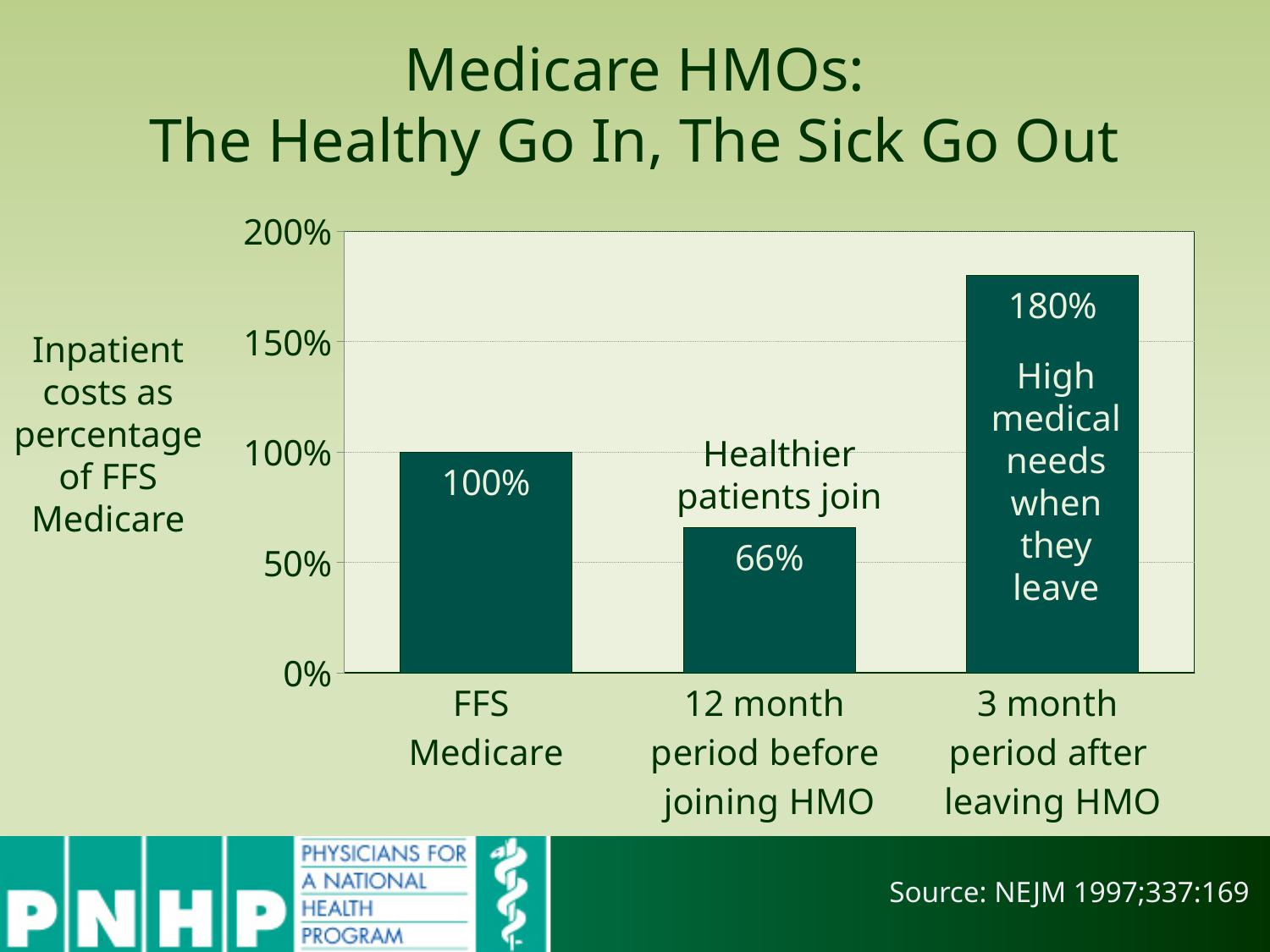
What is the value for the 3 month period after leaving HMO? 180% What kind of chart is shown on the slide? bar chart What does the y axis of the chart measure, according to the label on the left? Inpatient costs as percentage of FFS Medicare What is the value for FFS Medicare? 100% Is the value for the 3 month period after leaving HMO greater or less than 150%? greater What is the value for the 12 month period before joining HMO? 66% Which is larger, the value for FFS Medicare or the value for the 12 month period before joining HMO? FFS Medicare How many categories are shown on the chart? 3 What is the difference between the value for FFS Medicare and the value for the 12 month period before joining HMO? 34% Which category has the lowest value? 12 month period before joining HMO What is the difference between the value for the 3 month period after leaving HMO and the value for FFS Medicare? 80% Which category has the highest value? 3 month period after leaving HMO